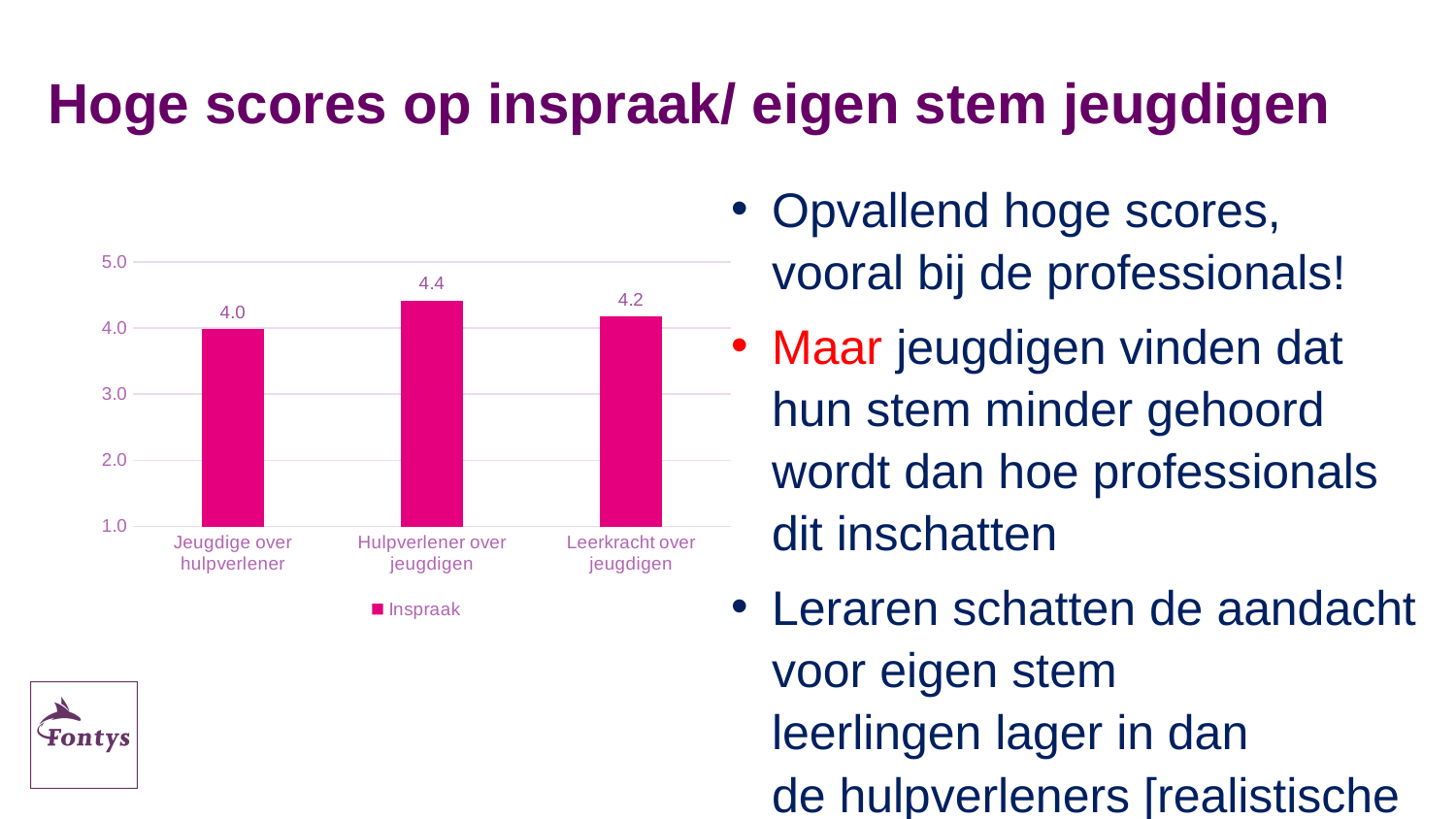
Which category has the lowest value? Jeugdige over hulpverlener What is the value for "Hulpverlener over jeugdigen"? 4.4 How many categories are shown on the x axis? 3 How many series does the legend list? 1 Is the value for "Leerkracht over jeugdigen" greater or less than 4.0? greater What is the value for "Leerkracht over jeugdigen"? 4.2 What kind of chart is shown on the slide? bar chart What is the difference between the values for "Hulpverlener over jeugdigen" and "Jeugdige over hulpverlener"? 0.4 What is the difference between the values for "Leerkracht over jeugdigen" and "Jeugdige over hulpverlener"? 0.2 What is the value for "Jeugdige over hulpverlener"? 4.0 Which is larger: the value for "Hulpverlener over jeugdigen" or "Leerkracht over jeugdigen"? Hulpverlener over jeugdigen Which category has the highest value? Hulpverlener over jeugdigen